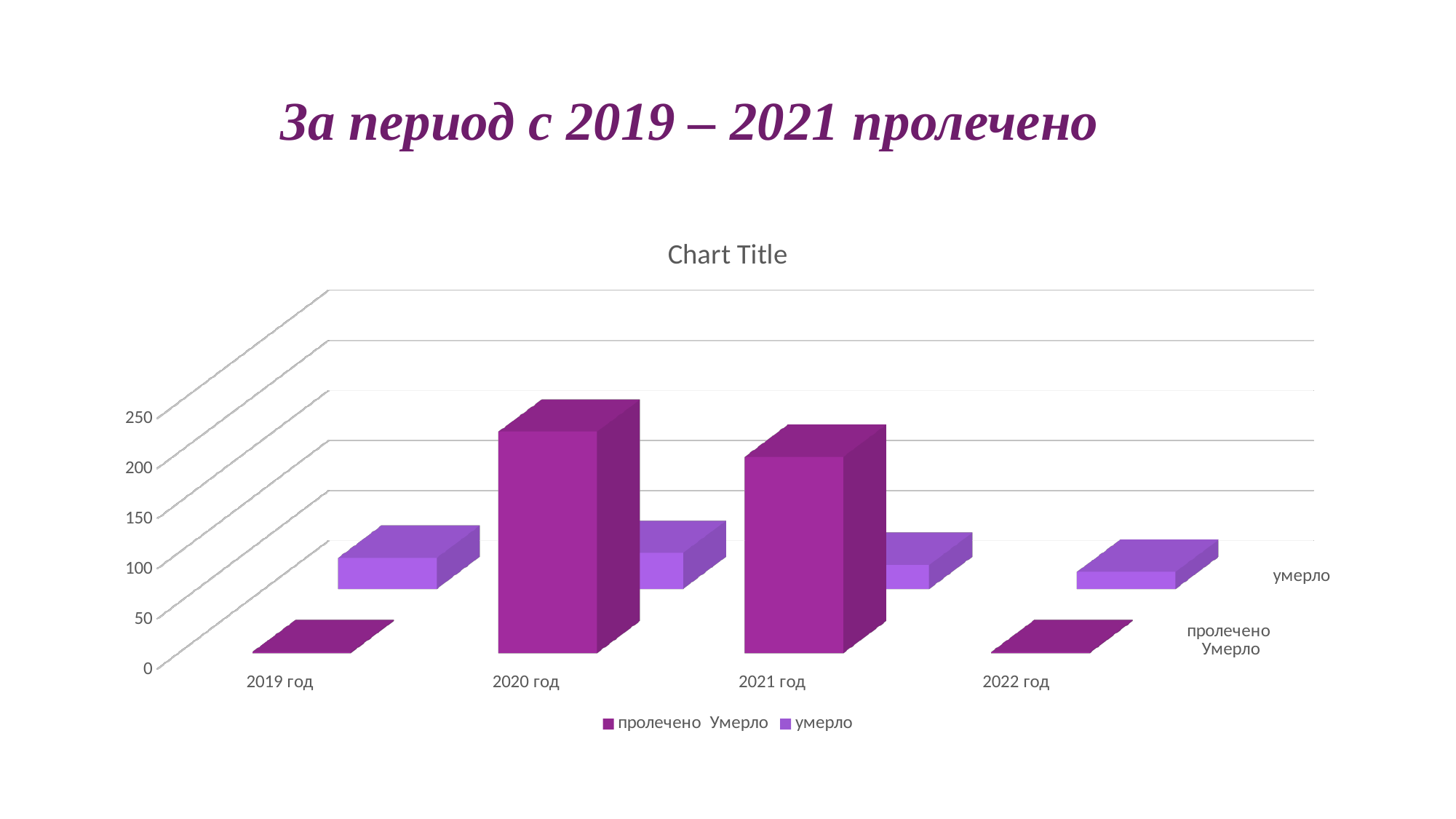
How many series does the chart legend list? 2 Which is larger, the 'пролечено Умерло' value for 2020 год or for 2021 год? 2020 год What kind of chart is shown on the slide? bar chart Is the 'умерло' value for 2019 год greater or less than 100? less What is the title printed above the chart? Chart Title Is the 'пролечено Умерло' value for 2021 год greater or less than 150? greater For 2020 год, which series has the larger value, 'пролечено Умерло' or 'умерло'? пролечено Умерло Which year has the highest value for the 'пролечено Умерло' series? 2020 год Does the 'пролечено Умерло' series rise or fall from 2020 год to 2021 год? fall How many year categories are shown on the x axis of the chart? 4 Is the 'пролечено Умерло' value for 2020 год greater or less than 200? greater Which year has the lowest value for the 'умерло' series? 2022 год